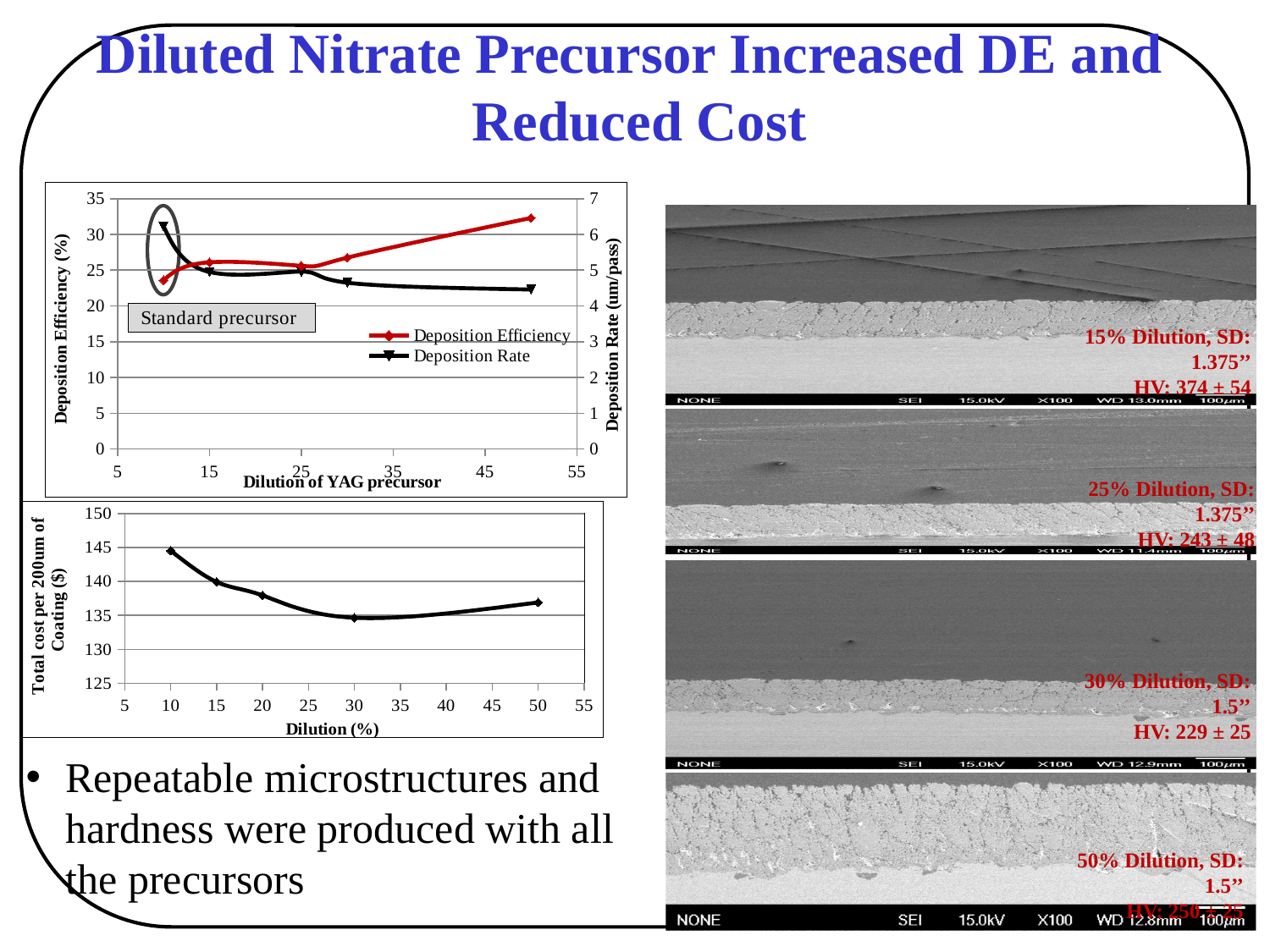
In the bottom chart, which has the higher total cost per 200um of coating: a dilution of 10% or a dilution of 50%? 10% In the top chart, does the Deposition Rate generally rise or fall as the dilution increases from 10 to 50? fall What kind of chart is the bottom chart, which plots Total cost per 200um of Coating against Dilution? Line chart In the top chart, at which dilution of YAG precursor is the Deposition Efficiency highest? 50 In the top chart, what are the two series named in the legend? Deposition Efficiency and Deposition Rate What kind of chart is the top chart, which plots Deposition Efficiency and Deposition Rate against Dilution of YAG precursor? Line chart In the bottom chart, is the total cost at a dilution of 10% greater or less than $140? greater In the top chart, is the Deposition Efficiency at a dilution of 50 greater or less than 30? greater In the top chart (Deposition Efficiency and Deposition Rate), how many series does the legend list? 2 In the bottom chart (Total cost per 200um of Coating), at which dilution is the cost lowest? 30 In the top chart, is the Deposition Rate at a dilution of 10 greater or less than 5 um/pass? greater In the top chart, what does the grey text box label the circled points at a dilution of 10? Standard precursor